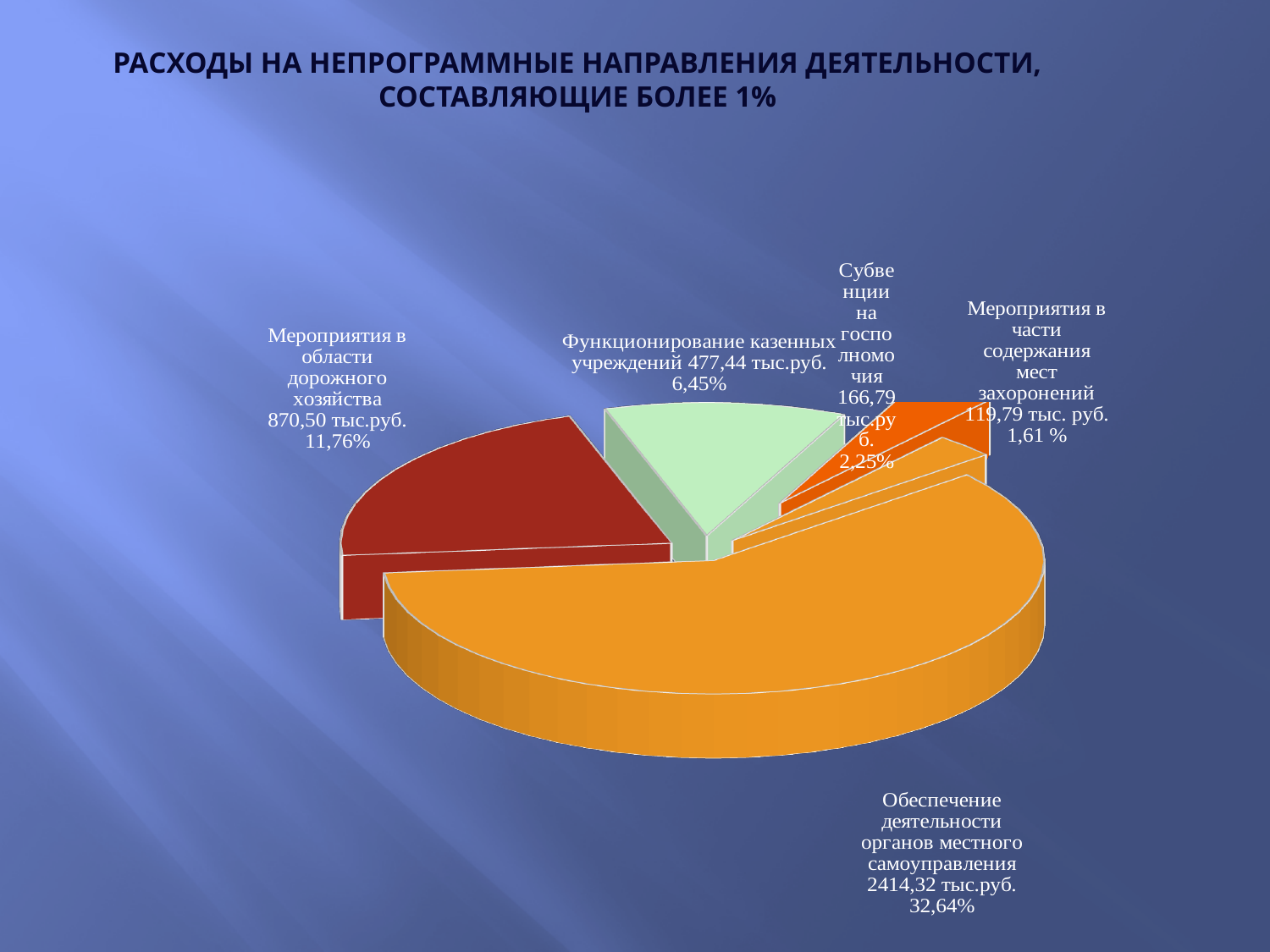
What is the value for Мероприятия в области дорожного хозяйства? 870,50 тыс.руб. What is the value for Субвенции на госполномочия? 166,79 тыс.руб. How many slices does the pie chart have? 5 What percentage is shown for Обеспечение деятельности органов местного самоуправления? 32,64% What is the difference between Мероприятия в области дорожного хозяйства and Функционирование казенных учреждений in тыс.руб.? 393,06 тыс.руб. Which category has the largest slice? Обеспечение деятельности органов местного самоуправления Which is larger: Мероприятия в области дорожного хозяйства or Функционирование казенных учреждений? Мероприятия в области дорожного хозяйства What is the value for Обеспечение деятельности органов местного самоуправления? 2414,32 тыс.руб. What kind of chart is shown on the slide? Pie chart Which category has the smallest slice? Мероприятия в части содержания мест захоронений What is the value for Функционирование казенных учреждений? 477,44 тыс.руб. What percentage is shown for Мероприятия в части содержания мест захоронений? 1,61 %